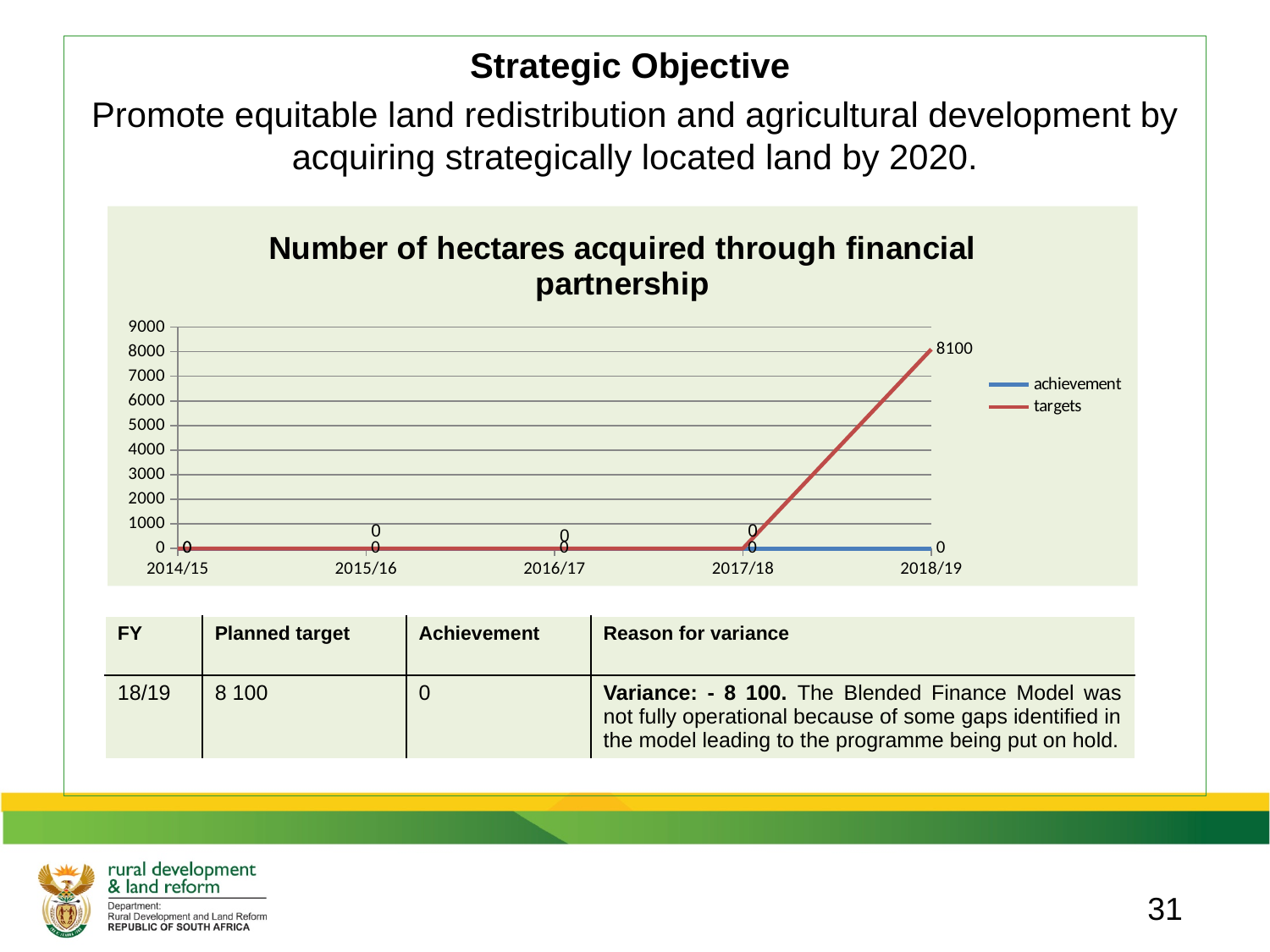
Does the targets line rise or fall between 2017/18 and 2018/19? rise What is the achievement value for 2018/19? 0 How many years are shown on the x axis? 5 How many series does the legend list? 2 Which year has the highest targets value? 2018/19 Which is larger for 2018/19, the targets value or the achievement value? targets What kind of chart is shown? line chart What is the targets value for 2018/19? 8100 What is the targets value for 2017/18? 0 What is the difference between the targets and achievement values for 2018/19? 8100 What is the title of the chart? Number of hectares acquired through financial partnership Is the targets value for 2018/19 greater or less than 8000? greater